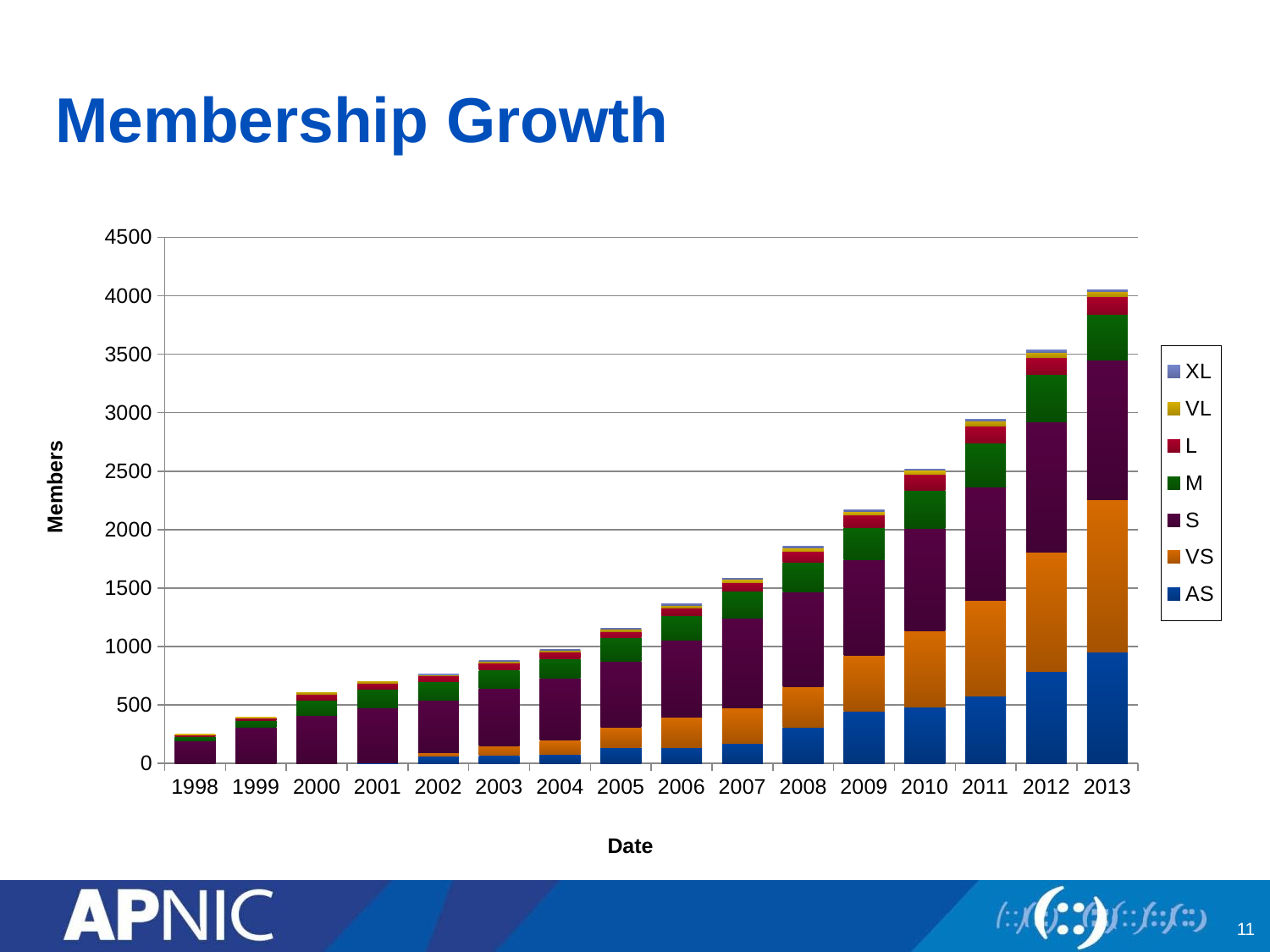
Which year has the shortest stacked bar? 1998 How many series does the legend list? 7 Which year has the larger total, 2006 or 2009? 2009 Is the total for 2008 greater or less than 2000? less Which year has the tallest stacked bar? 2013 What is the title of the chart? Membership Growth What is the label on the y axis? Members Is the total for 2013 greater or less than 3500? greater How many years are shown on the x axis of the chart? 16 Do total members rise or fall from 1998 to 2013? rise What kind of chart is shown on the slide? stacked bar chart Is the total for 1998 greater or less than 500? less